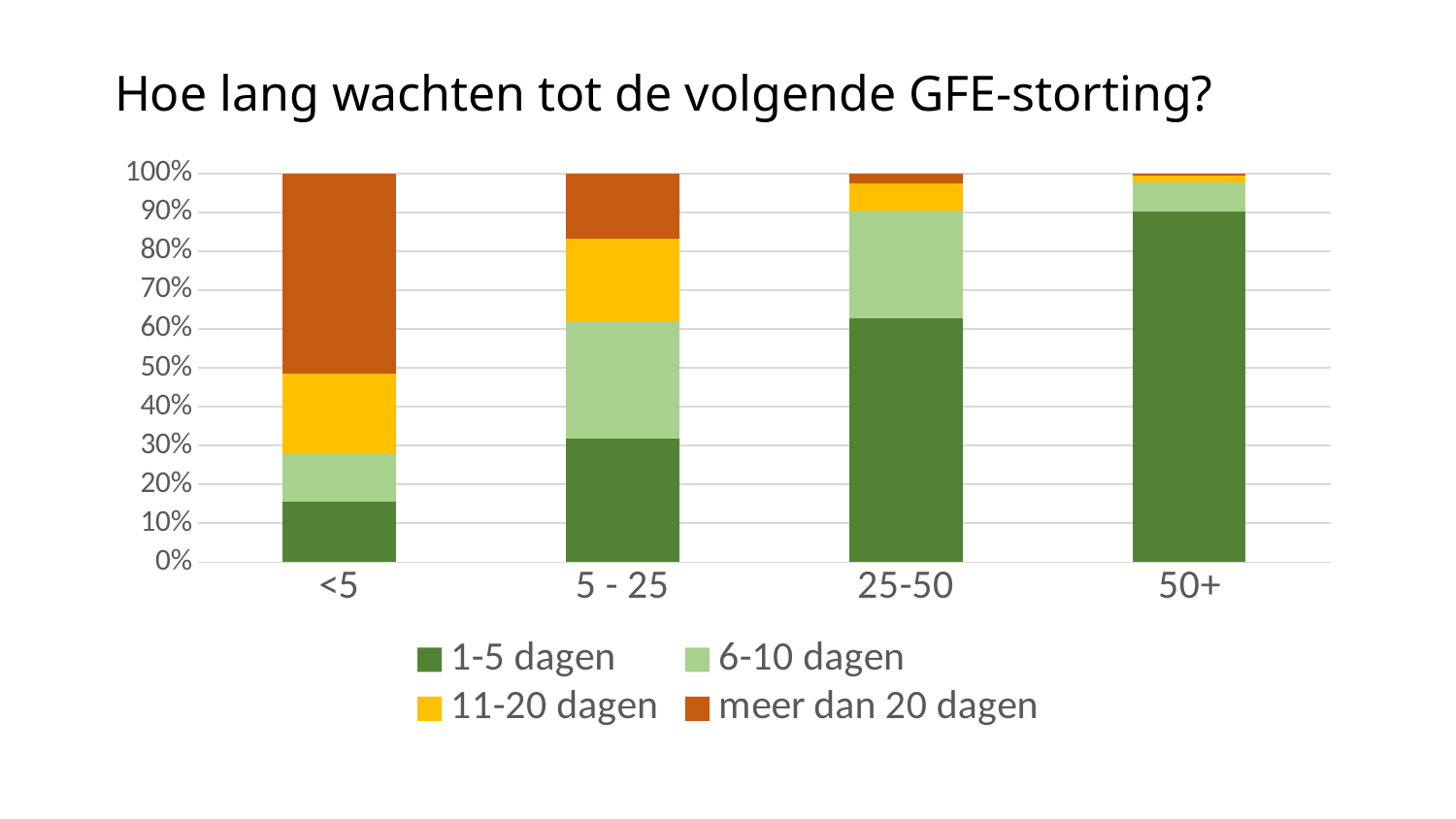
Which category has the largest share of 1-5 dagen? 50+ Is the value for 6-10 dagen in the 25-50 category greater or less than 20%? greater Is the value for 1-5 dagen in the <5 category greater or less than 20%? less Is the share of meer dan 20 dagen larger in the <5 category or the 5 - 25 category? <5 How many categories are shown on the x axis? 4 Does the share of 1-5 dagen rise or fall moving from <5 to 50+ along the x axis? rise Is the value for 1-5 dagen in the 50+ category greater or less than 80%? greater Which category has the smallest share of 1-5 dagen? <5 How many series does the legend list? 4 What is the title of the chart? Hoe lang wachten tot de volgende GFE-storting? What kind of chart is shown on the slide? Stacked bar chart What is the total of the stacked bar for the <5 category? 100%